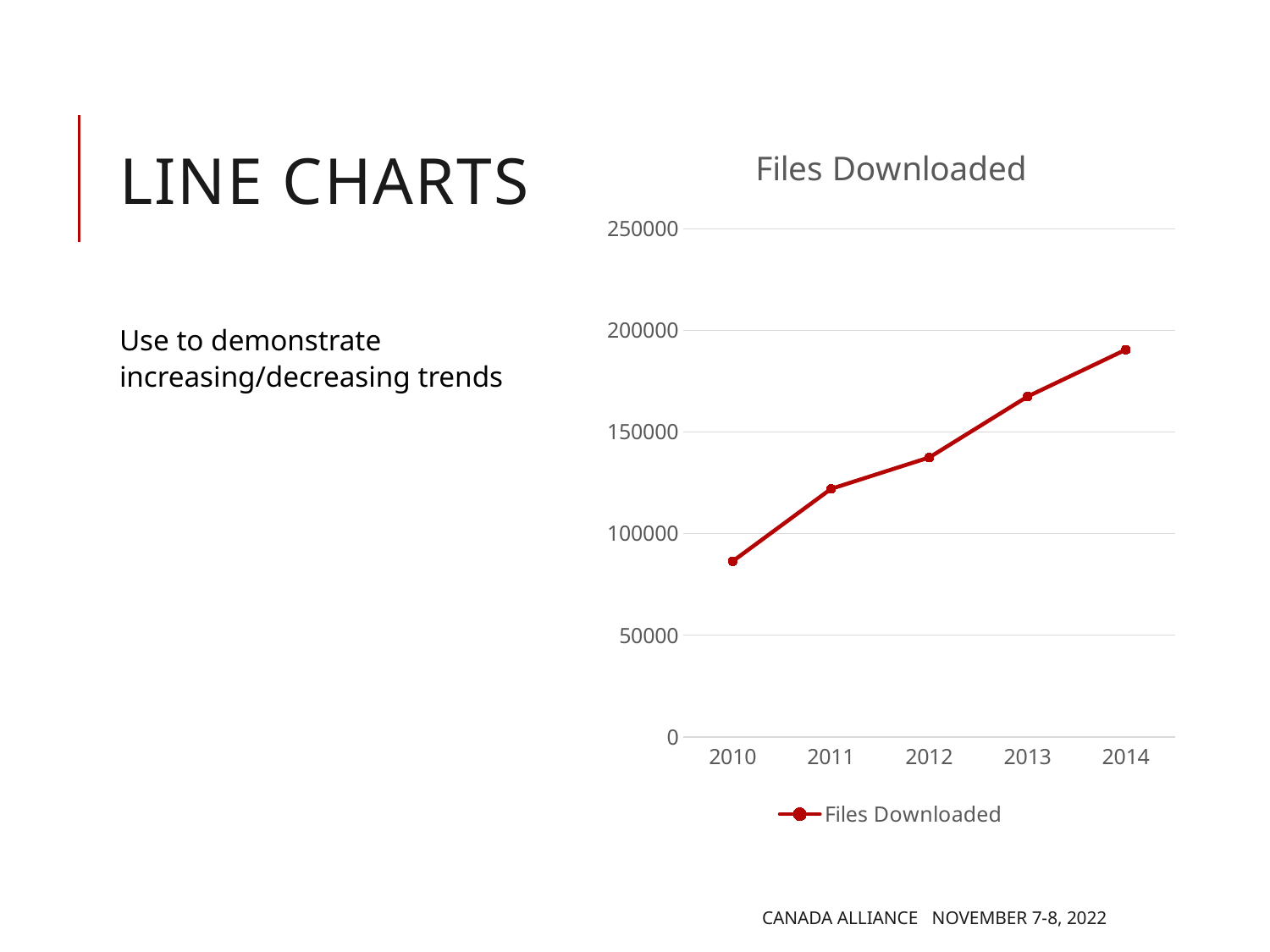
What type of chart is shown on the slide? line chart What is the name of the series shown in the legend? Files Downloaded How many data points are plotted on the line? 5 Is the value for 2010 greater or less than 100000? less Is the value for 2013 greater or less than 150000? greater Which year has the lowest value for Files Downloaded? 2010 Do the values rise or fall from 2010 to 2014? rise Which is larger, the value for 2011 or the value for 2013? 2013 How many series does the legend list? 1 Is the value for 2014 greater or less than 200000? less What is the title of the chart? Files Downloaded Which year has the highest value for Files Downloaded? 2014